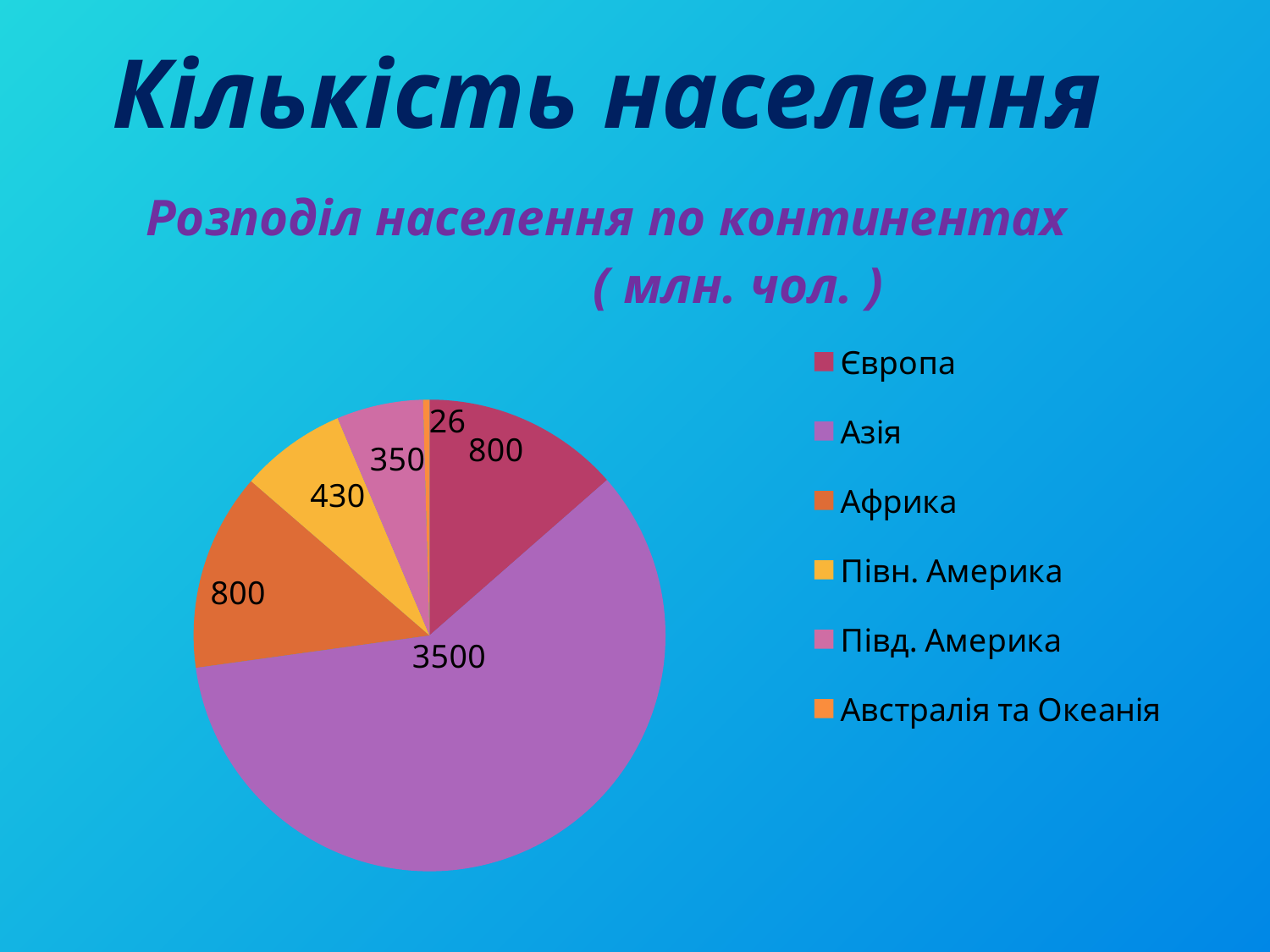
What is the difference between the values for Азія and Європа? 2700 How many continents (slices) are shown in the pie chart? 6 Which is larger, the value for Півн. Америка or Півд. Америка? Півн. Америка What is the value for Азія in the pie chart? 3500 What is the value for Австралія та Океанія in the pie chart? 26 What kind of chart is shown on the slide? Pie chart What is the total of all the values shown in the pie chart? 5906 Which continent has the smallest slice in the pie chart? Австралія та Океанія What is the value for Півн. Америка in the pie chart? 430 What is the title of the chart? Розподіл населення по континентах ( млн. чол. ) Which continent has the largest slice in the pie chart? Азія What is the value for Півд. Америка in the pie chart? 350